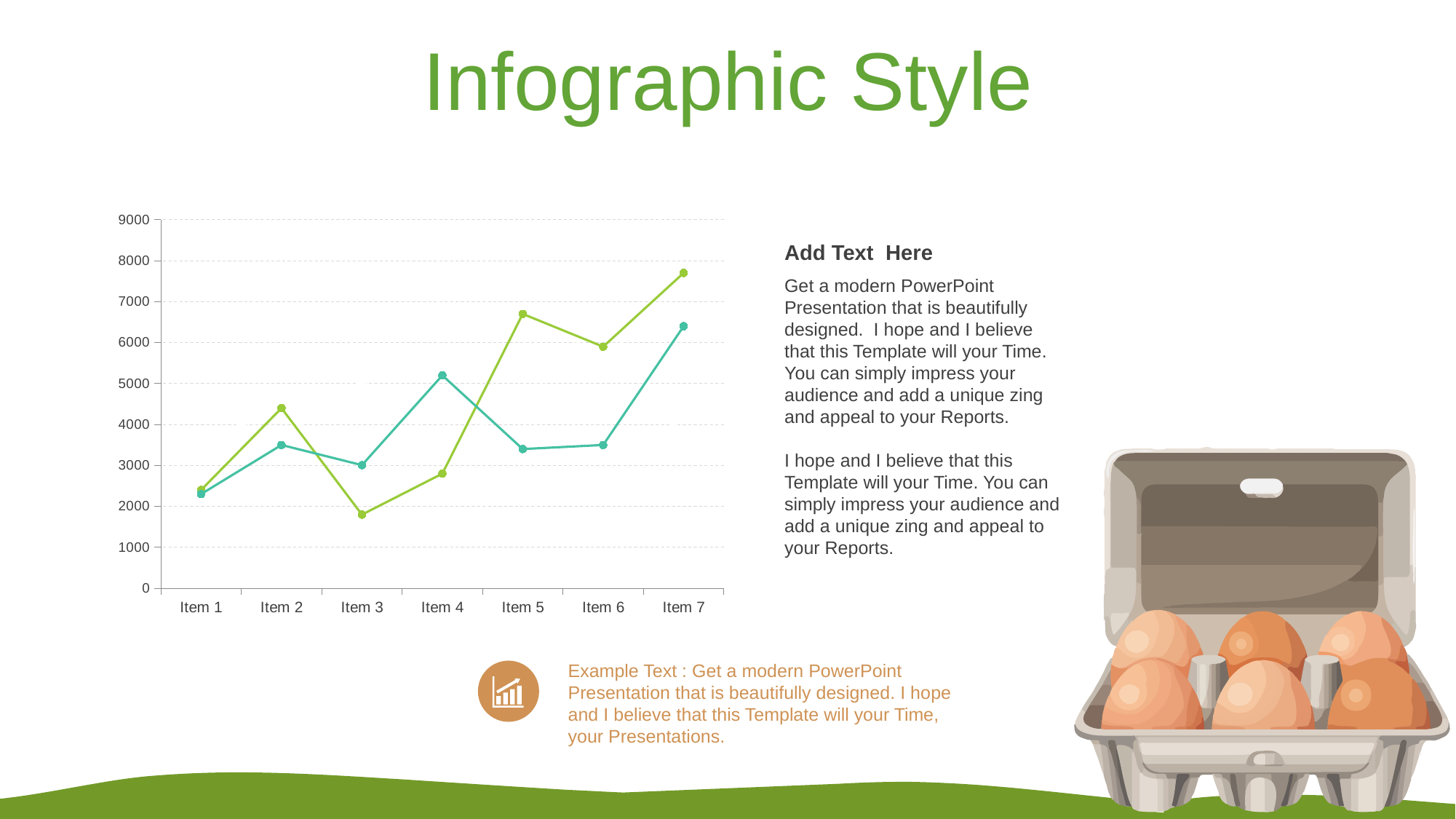
Is the value of the teal line at Item 6 greater or less than 4000? less Does the light green line rise or fall from Item 5 to Item 6? fall Is the value of the light green line at Item 7 greater or less than 7000? greater Is the value of the light green line at Item 3 greater or less than 2000? less How many lines (series) are plotted on the chart? 2 At which item does the teal line reach its highest value? Item 7 What kind of chart is shown on the slide? line chart How many categories are shown on the x axis of the chart? 7 At which item does the light green line reach its highest value? Item 7 At which item does the light green line reach its lowest value? Item 3 At Item 5, which line has the higher value, the light green line or the teal line? the light green line